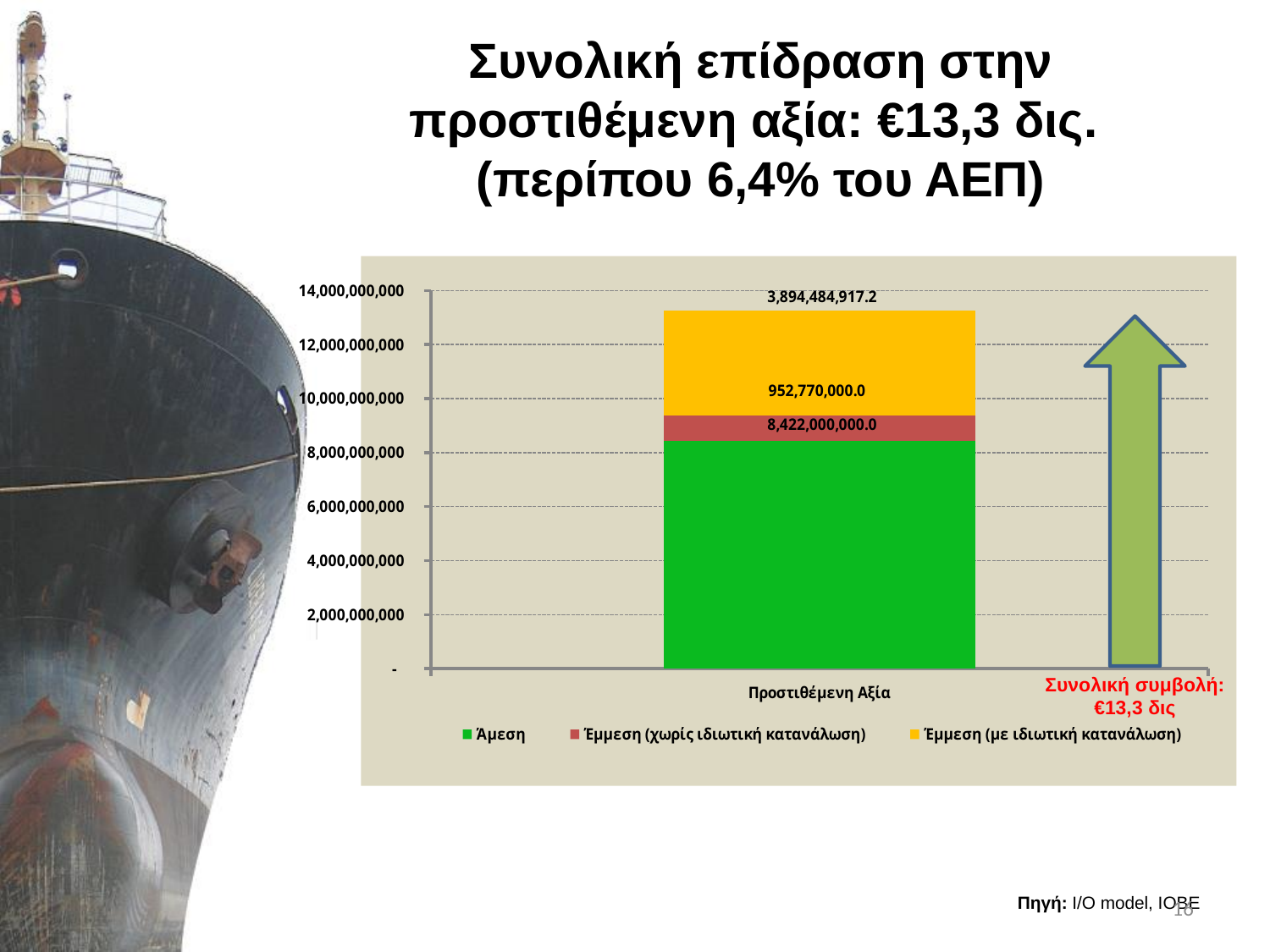
What is the value of the Έμμεση (με ιδιωτική κατανάλωση) series? 3,894,484,917.2 What kind of chart is shown on the slide? Stacked bar chart Which is larger: the Έμμεση (με ιδιωτική κατανάλωση) value or the Έμμεση (χωρίς ιδιωτική κατανάλωση) value? Έμμεση (με ιδιωτική κατανάλωση) How many series does the chart legend list? 3 What is the value of the Έμμεση (χωρίς ιδιωτική κατανάλωση) series? 952,770,000.0 Which series has the largest value in the stacked bar? Άμεση How many categories are shown on the x axis of the chart? 1 What is the difference between the Άμεση value and the Έμμεση (χωρίς ιδιωτική κατανάλωση) value? 7,469,230,000.0 What is the total of the stacked bar for Προστιθέμενη Αξία? 13,269,254,917.2 What is the value of the Άμεση series for Προστιθέμενη Αξία? 8,422,000,000.0 Which series has the smallest value in the stacked bar? Έμμεση (χωρίς ιδιωτική κατανάλωση) What colour represents the Άμεση series in the chart? Green